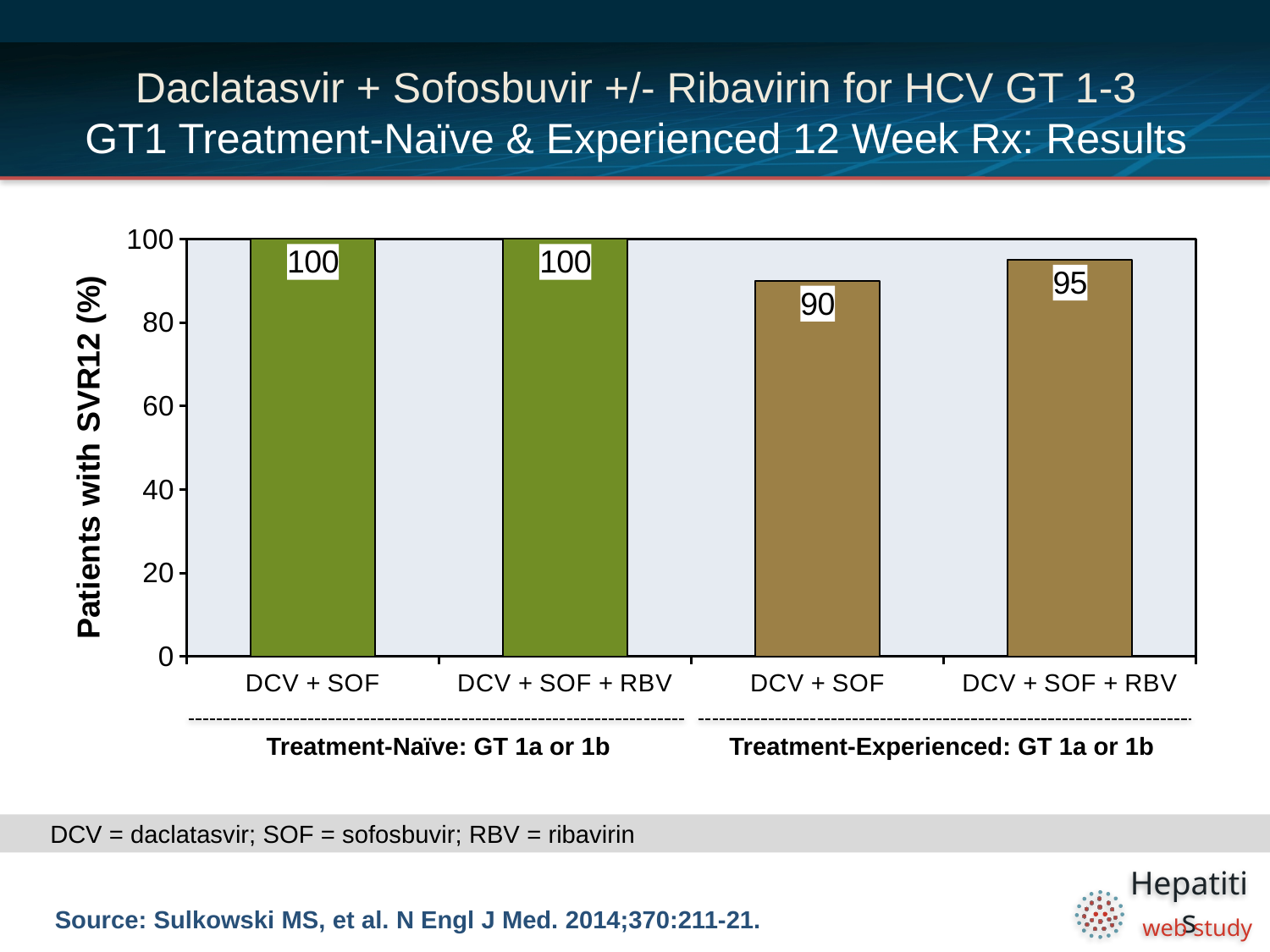
Is the SVR12 rate for DCV + SOF in the Treatment-Experienced group greater or less than 80? greater What is the difference in SVR12 rate for DCV + SOF between the Treatment-Naïve and Treatment-Experienced groups? 10 What is the SVR12 rate for DCV + SOF in the Treatment-Experienced group? 90 What is the label of the y-axis? Patients with SVR12 (%) Which bar has the lowest SVR12 rate? DCV + SOF (Treatment-Experienced) What type of chart is shown on the slide? bar chart What is the difference in SVR12 rate between DCV + SOF + RBV and DCV + SOF in the Treatment-Experienced group? 5 What colour are the bars for the Treatment-Naïve group? green How many bars are shown in the chart? 4 Which is larger: the SVR12 rate for DCV + SOF in the Treatment-Naïve group or in the Treatment-Experienced group? Treatment-Naïve What is the SVR12 rate for DCV + SOF + RBV in the Treatment-Experienced group? 95 What is the SVR12 rate for DCV + SOF in the Treatment-Naïve group? 100